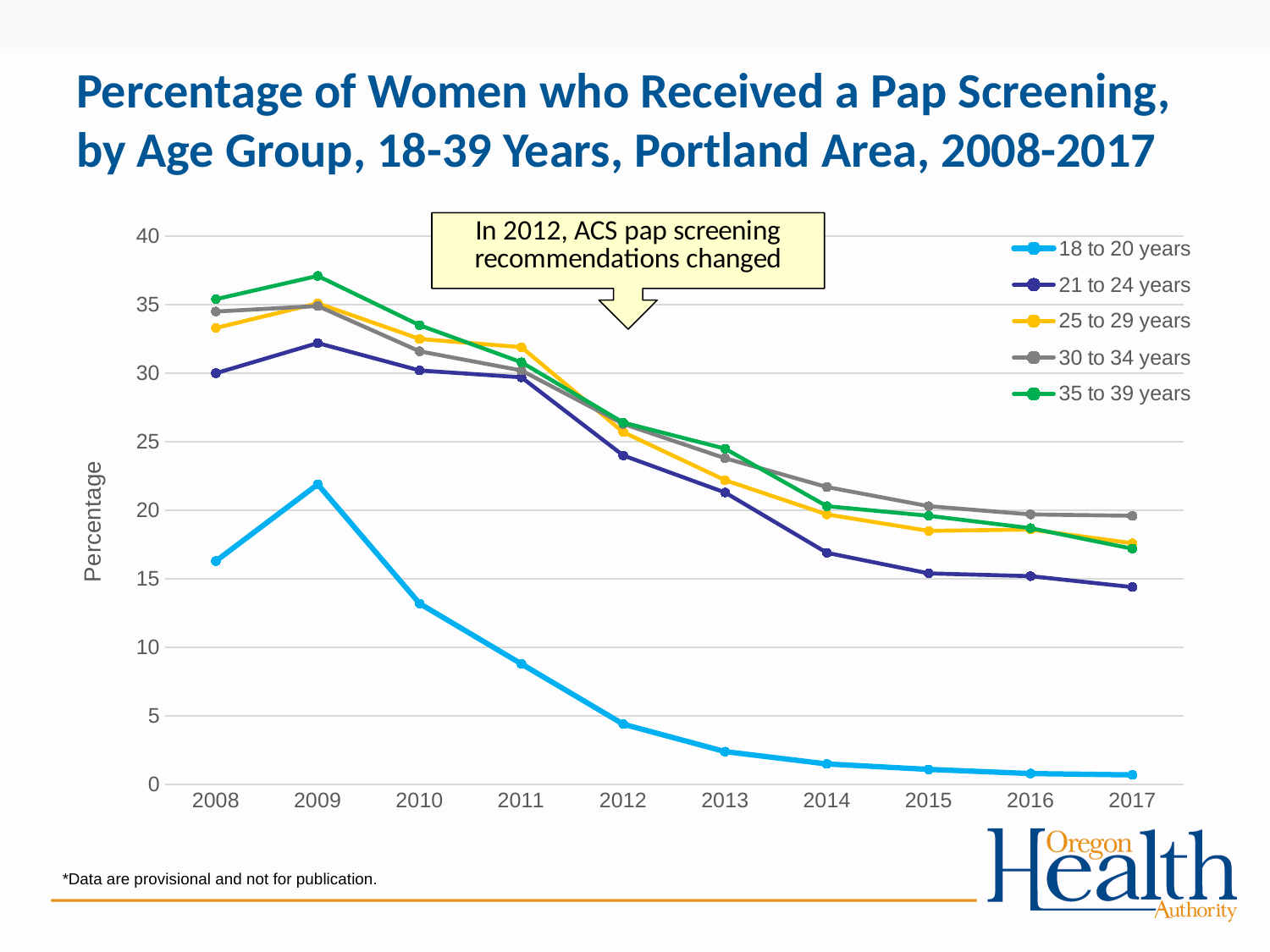
Which age group has the highest value in 2009? 35 to 39 years What kind of chart is shown on the slide? line chart How many series does the legend list? 5 Is the value for 18 to 20 years in 2013 greater or less than 5? less In 2017, which is larger: the value for 30 to 34 years or the value for 21 to 24 years? 30 to 34 years Does the value for 18 to 20 years rise or fall from 2009 to 2017? fall How many years are plotted along the x axis? 10 Does the value for 35 to 39 years rise or fall from 2009 to 2017? fall Is the value for 18 to 20 years in 2009 greater or less than 20? greater Is the value for 35 to 39 years in 2009 greater or less than 35? greater Which age group has the lowest value in 2017? 18 to 20 years